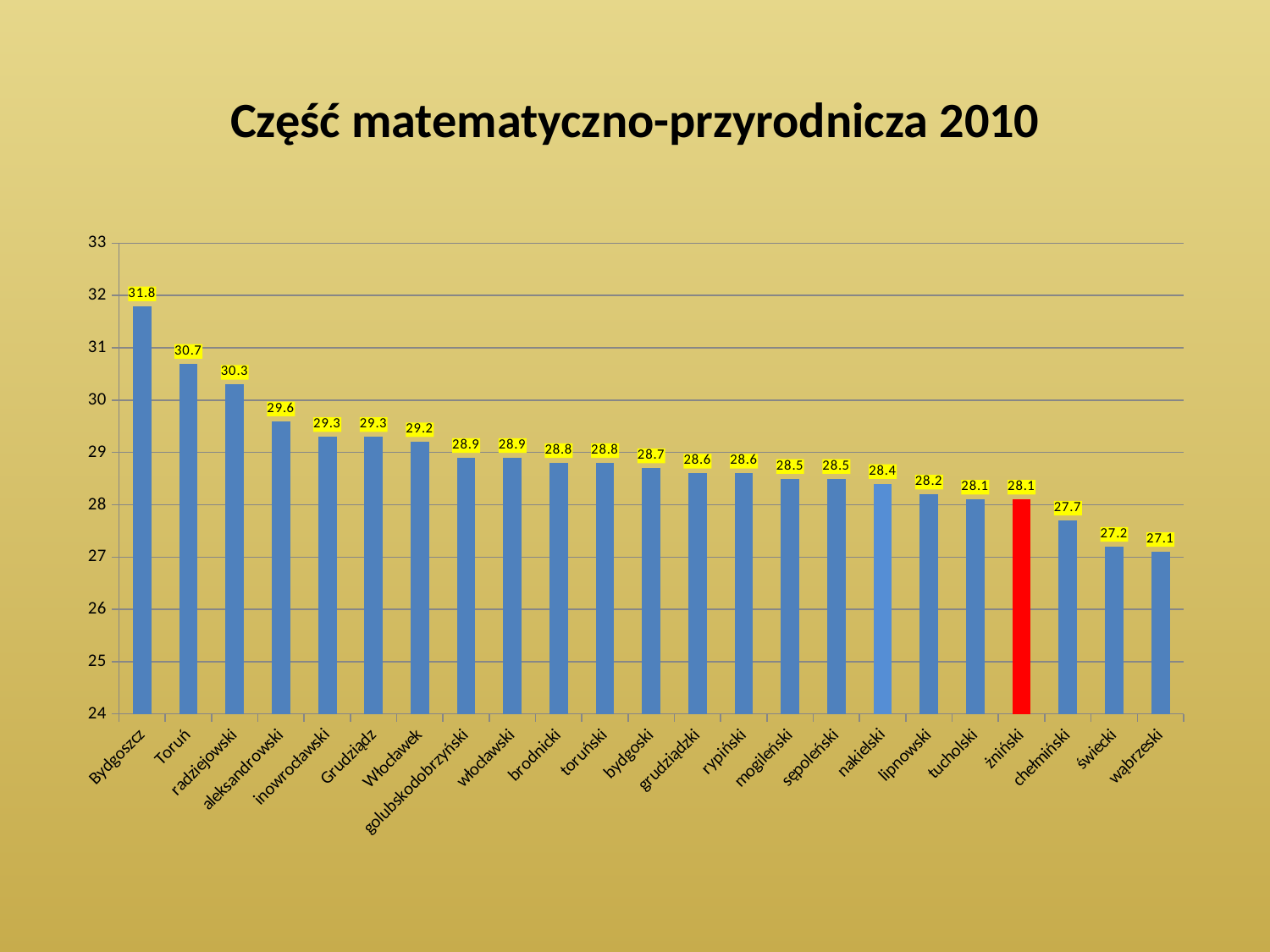
Which category has the highest value? Bydgoszcz What is the value for żniński? 28.1 How many categories are shown on the x axis? 23 What is the difference between the values for Bydgoszcz and wąbrzeski? 4.7 What is the difference between the values for Toruń and żniński? 2.6 What kind of chart is this? bar chart What is the value for Bydgoszcz? 31.8 Which category has the lowest value? wąbrzeski Which category's bar is coloured red? żniński Which is larger, the value for aleksandrowski or the value for chełmiński? aleksandrowski What is the value for nakielski? 28.4 What is the value for Grudziądz? 29.3